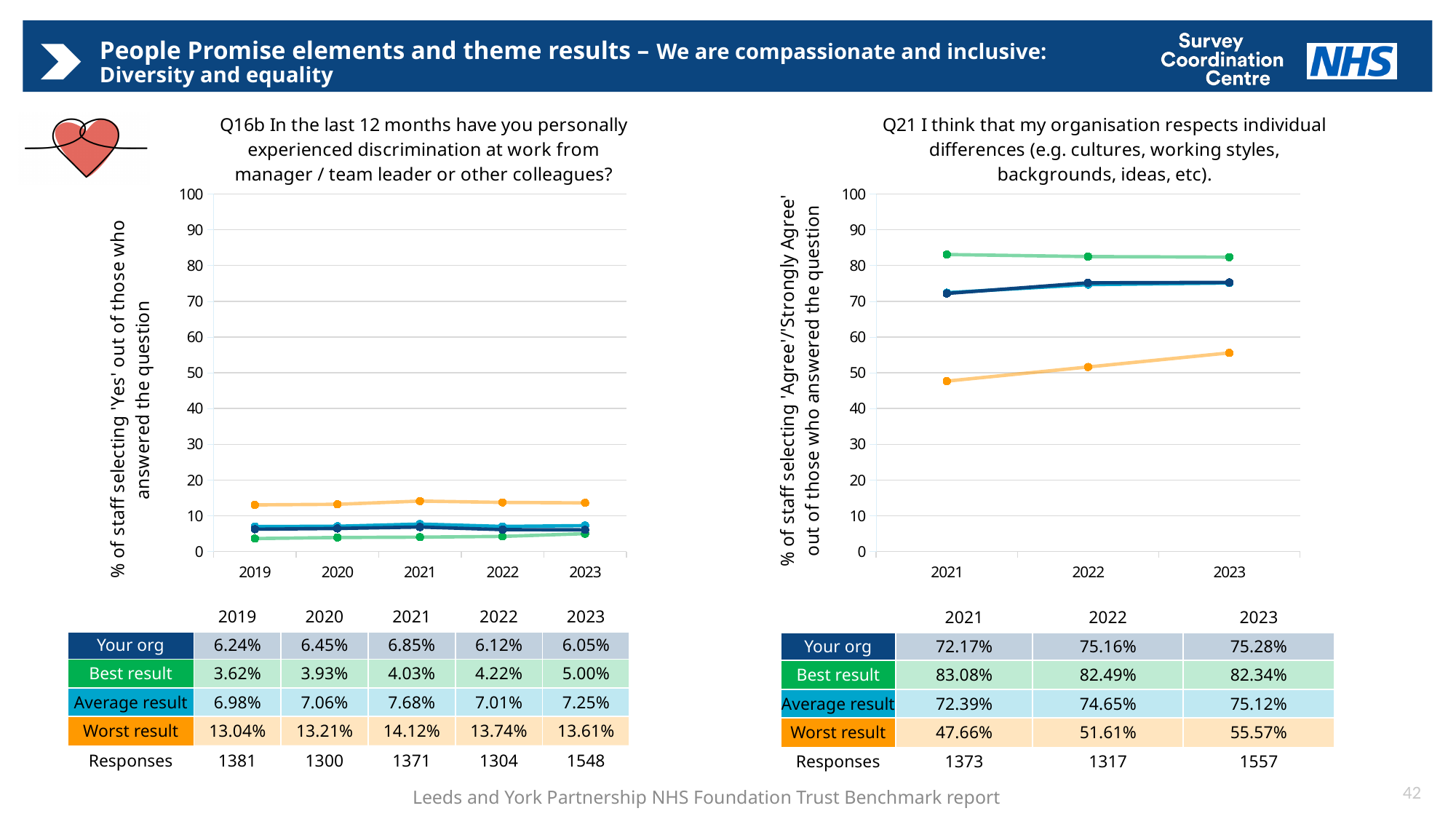
On the Q16b chart (left), how many responses were recorded for 2023? 1548 How many years are plotted on the x axis of the Q16b chart (left)? 5 On the Q21 chart (right), does the 'Worst result' line rise or fall from 2021 to 2023? Rise How many series are shown in the table below the Q21 chart (right), excluding the Responses row? 4 On the Q16b chart (left), which is larger in 2023: the 'Average result' or the 'Your org' value? Average result On the Q21 chart (right), which year has the lowest 'Your org' value? 2021 On the Q21 chart (right), is the 'Worst result' value for 2021 greater or less than 50? less On the Q21 chart (right), what is the difference between the 'Best result' and 'Your org' values in 2023? 7.06% On the Q16b chart (left), which year has the highest 'Worst result' value? 2021 On the Q16b chart (left), what is the 'Your org' value for 2021? 6.85% What type of chart is the Q21 chart (right)? Line chart On the Q21 chart (right), what is the 'Worst result' value for 2023? 55.57%